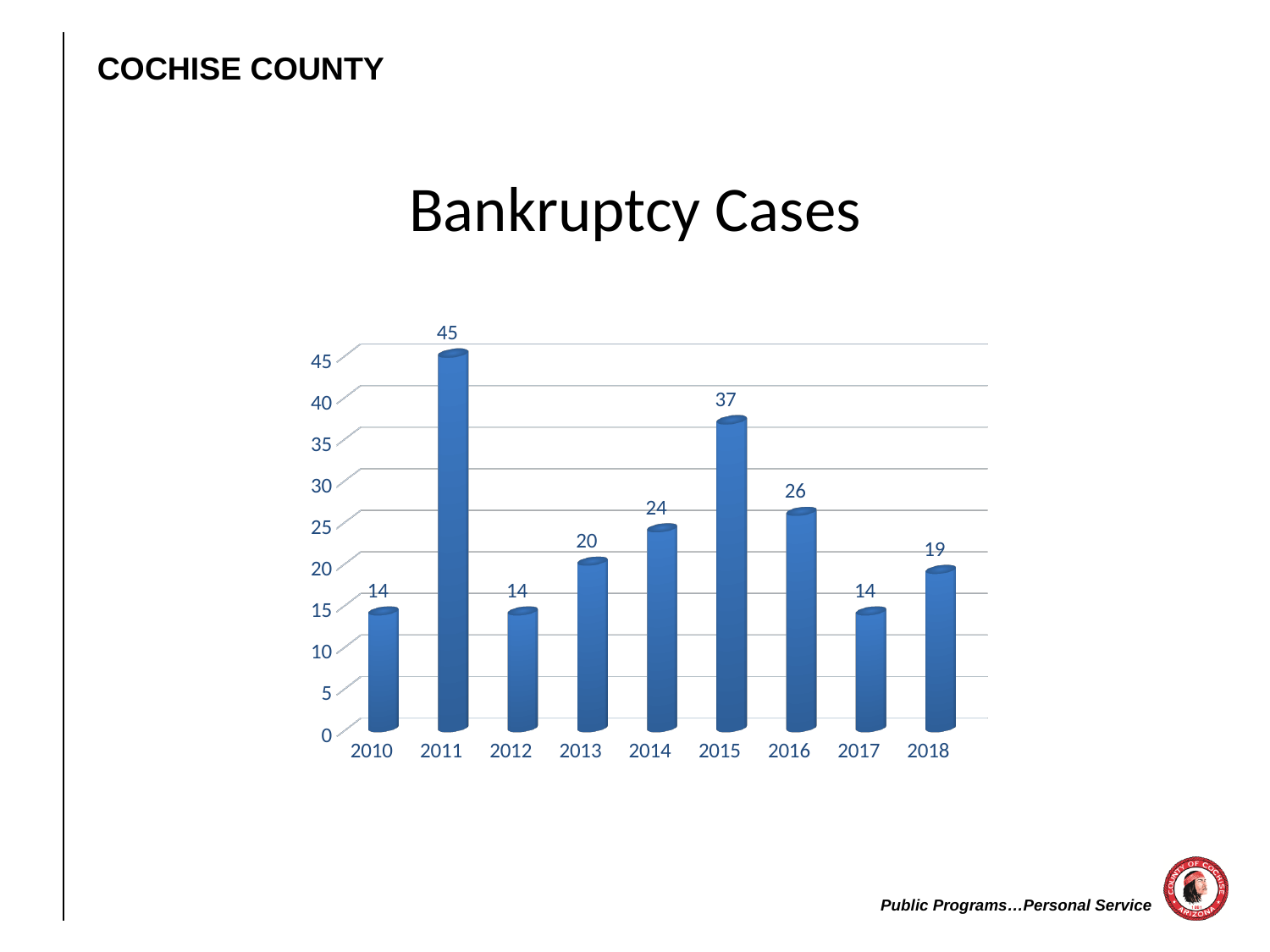
Which year has the highest number of bankruptcy cases? 2011 What is the title of the chart? Bankruptcy Cases How many years are shown on the x axis of the chart? 9 Do bankruptcy cases rise or fall from 2015 to 2017? Fall What is the number of bankruptcy cases in 2011? 45 What is the number of bankruptcy cases in 2015? 37 What is the difference in bankruptcy cases between 2011 and 2015? 8 Which year has more bankruptcy cases, 2013 or 2014? 2014 What kind of chart is shown on the slide? Bar chart What is the number of bankruptcy cases in 2018? 19 What is the difference in bankruptcy cases between 2016 and 2017? 12 Is the value for 2016 greater or less than 25? greater